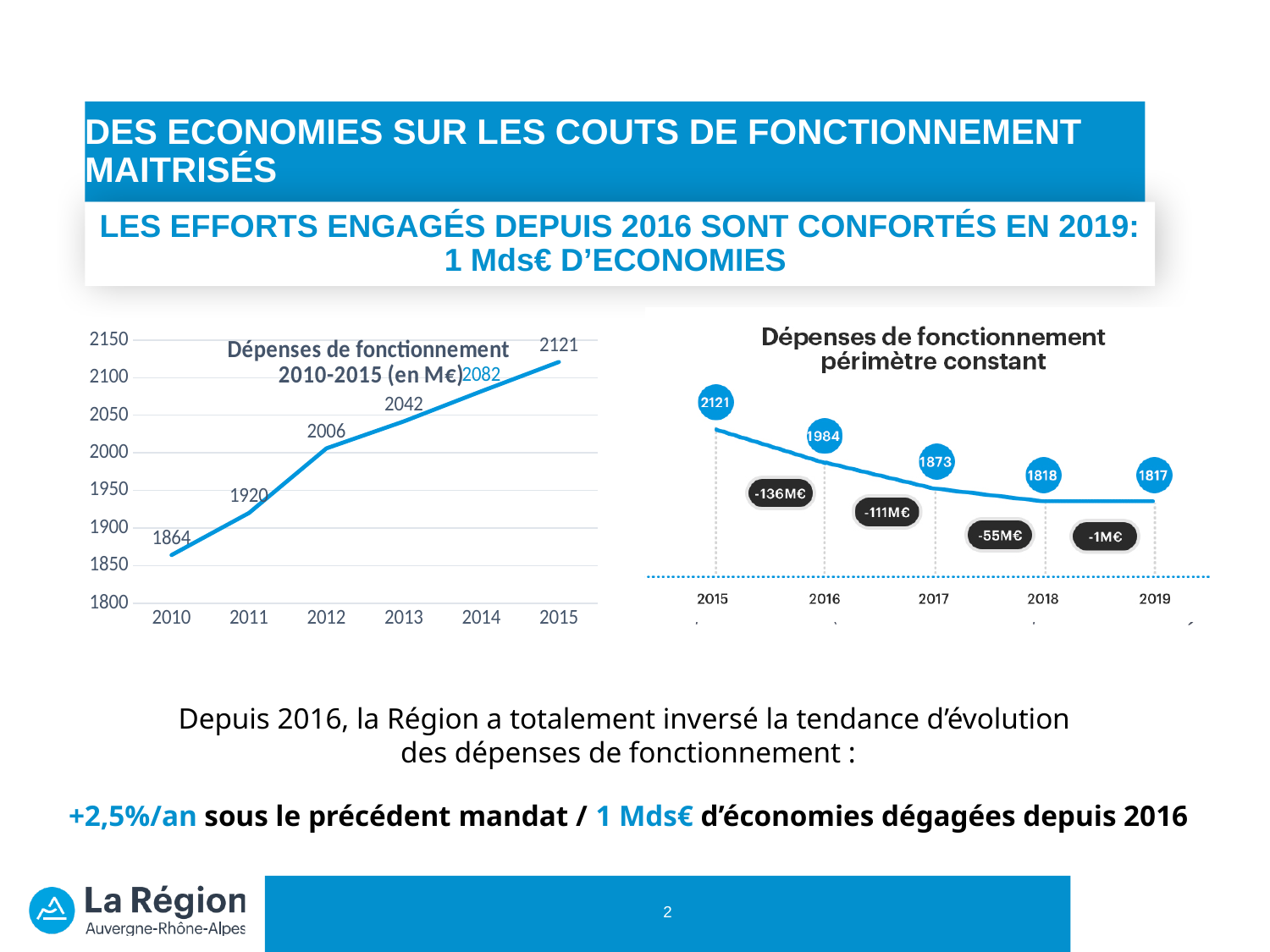
In the chart 'Dépenses de fonctionnement périmètre constant', do the values rise or fall from 2015 to 2019? fall What kind of chart is 'Dépenses de fonctionnement 2010-2015 (en M€)'? line chart In the chart 'Dépenses de fonctionnement périmètre constant', what is the value for 2017? 1873 In the chart 'Dépenses de fonctionnement 2010-2015 (en M€)', what is the value for 2013? 2042 In the chart 'Dépenses de fonctionnement périmètre constant', which year has the lowest value? 2019 In the chart 'Dépenses de fonctionnement 2010-2015 (en M€)', what is the value for 2010? 1864 In the chart 'Dépenses de fonctionnement 2010-2015 (en M€)', which year has the highest value? 2015 In the chart 'Dépenses de fonctionnement 2010-2015 (en M€)', which year has the lowest value? 2010 In the chart 'Dépenses de fonctionnement 2010-2015 (en M€)', what is the difference between the 2012 and 2011 values? 86 In the chart 'Dépenses de fonctionnement 2010-2015 (en M€)', do the values rise or fall from 2010 to 2015? rise In the chart 'Dépenses de fonctionnement périmètre constant', what change is shown between 2015 and 2016? -136M€ In the chart 'Dépenses de fonctionnement 2010-2015 (en M€)', how many years are plotted? 6